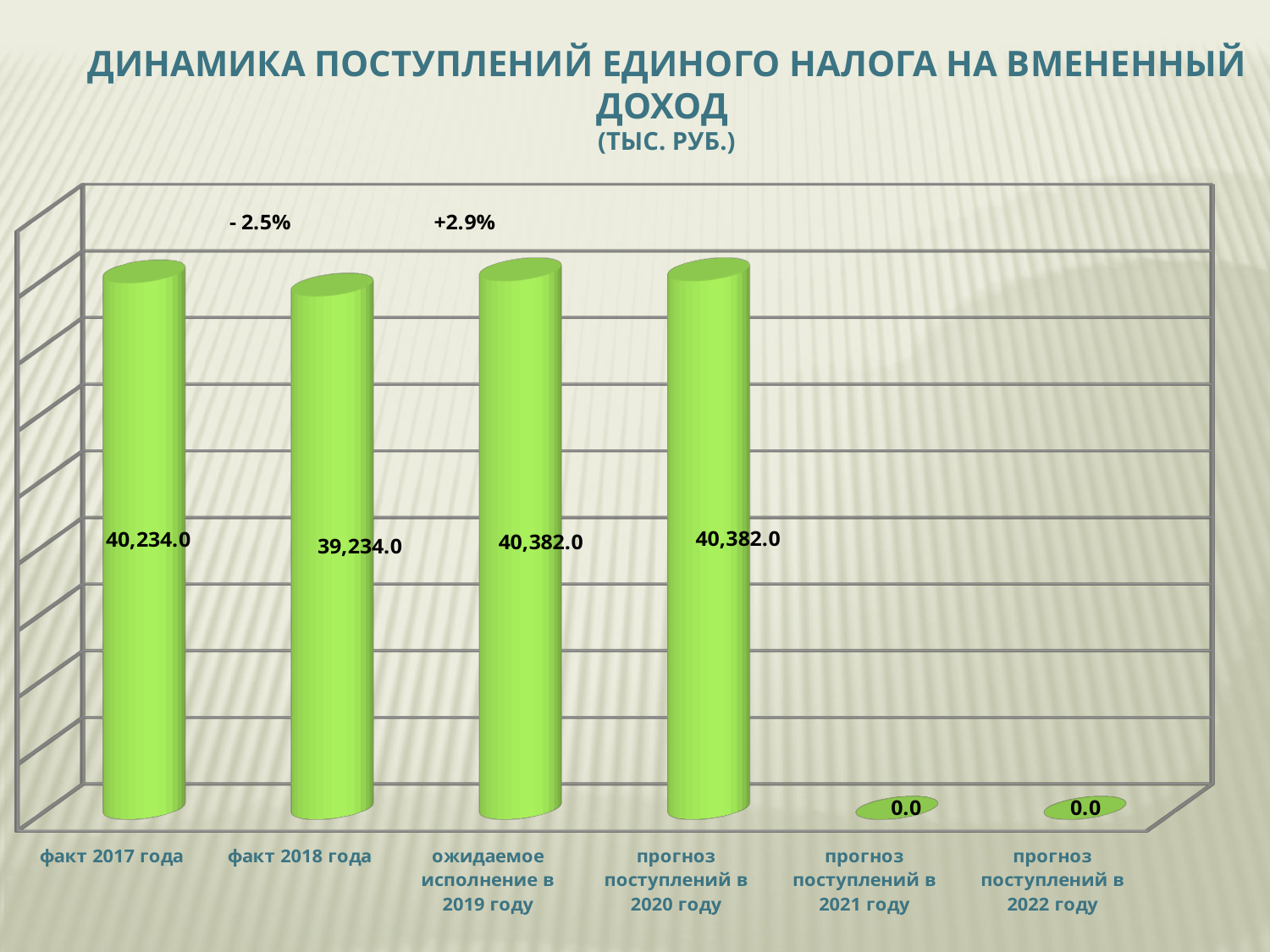
Does the value rise or fall from факт 2017 года to факт 2018 года? fall What percentage change is annotated above the bar for факт 2018 года? - 2.5% What is the difference between the values for факт 2017 года and факт 2018 года? 1,000.0 Which category has the lowest non-zero value? факт 2018 года What kind of chart is shown on the slide? bar chart How many categories are shown on the x axis? 6 Which is larger, the value for факт 2017 года or the value for прогноз поступлений в 2020 году? прогноз поступлений в 2020 году What is the value for факт 2018 года? 39,234.0 What is the value for ожидаемое исполнение в 2019 году? 40,382.0 What is the value for прогноз поступлений в 2021 году? 0.0 What unit is given in the chart title? тыс. руб. What is the value for факт 2017 года? 40,234.0